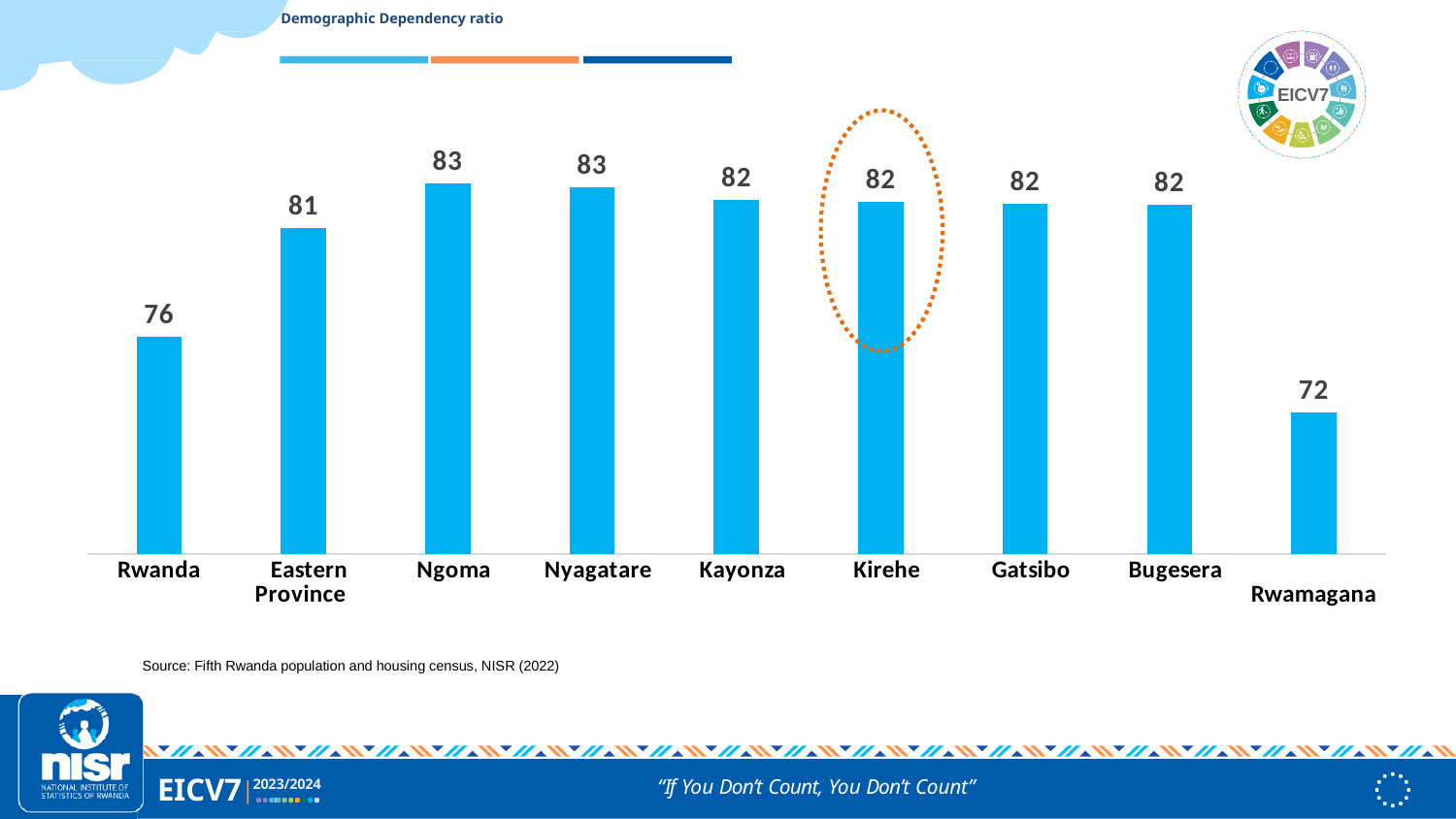
Which has a higher demographic dependency ratio, Rwanda or Eastern Province? Eastern Province Which category's bar is highlighted with a dotted orange circle? Kirehe What is the demographic dependency ratio for Ngoma? 83 How many categories are shown in the chart? 9 Which category has the lowest demographic dependency ratio? Rwamagana What is the difference between the demographic dependency ratio of Ngoma and Rwamagana? 11 What is the difference between the demographic dependency ratio of Eastern Province and Rwanda? 5 What kind of chart is shown on the slide? Bar chart What is the demographic dependency ratio for Rwanda? 76 What is the demographic dependency ratio for Kirehe? 82 What is the demographic dependency ratio for Eastern Province? 81 What is the demographic dependency ratio for Rwamagana? 72